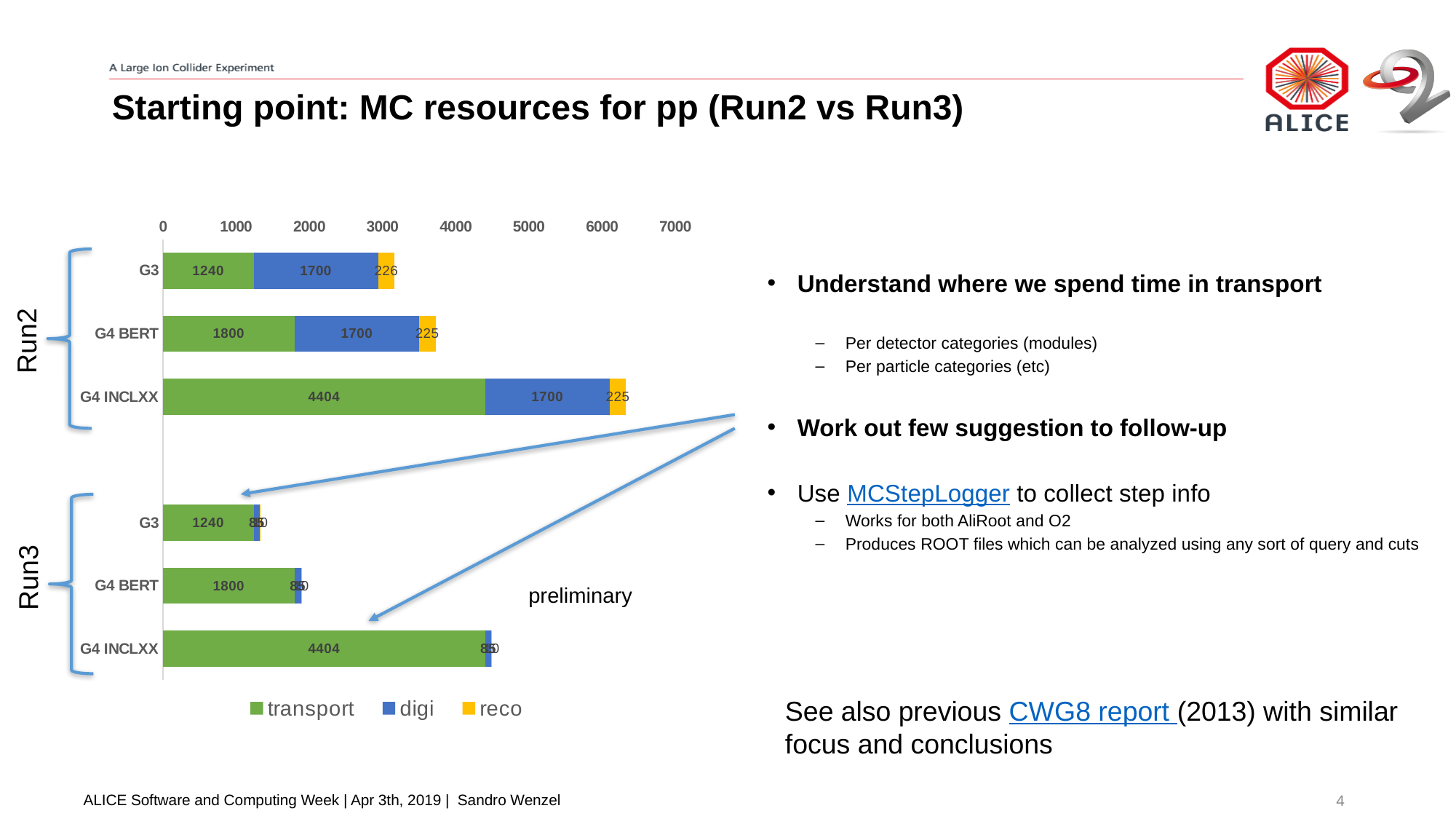
What is the transport value for G3 in Run3? 1240 Which series is shown in green in the legend? transport What is the difference between the transport values of G4 BERT and G3 in Run2? 560 What is the transport value for G4 INCLXX in Run2? 4404 Which is larger, the transport value for G4 BERT in Run2 or the transport value for G3 in Run2? G4 BERT Which category has the highest transport value? G4 INCLXX What kind of chart is shown on the slide? bar chart What is the reco value for G3 in Run2? 226 How many bars are plotted in the chart? 6 What is the digi value for G4 BERT in Run2? 1700 How many series does the legend list? 3 What is the total of the stacked bar for G4 INCLXX in Run2? 6329